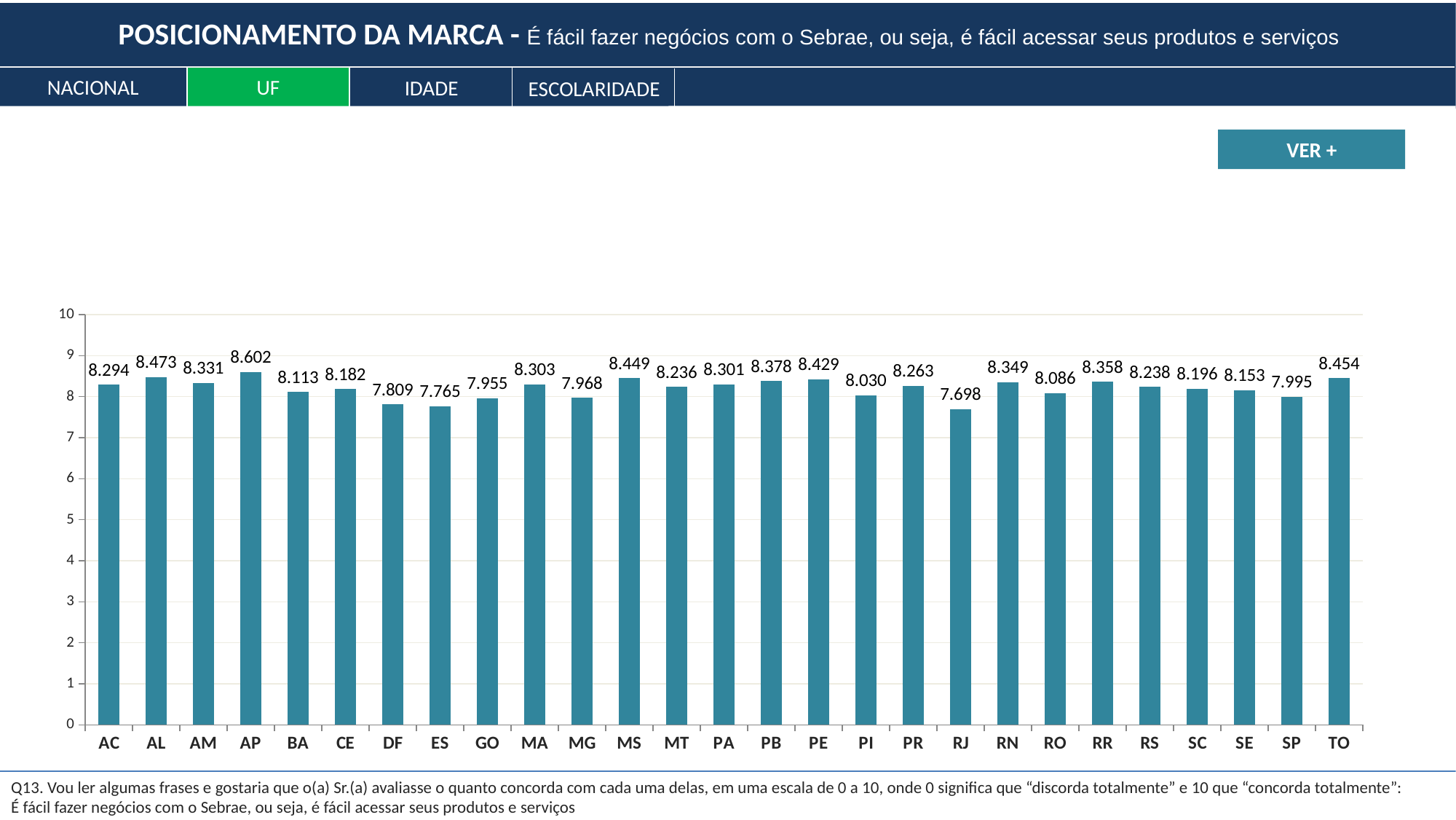
What is the difference between the values for AP and RJ? 0.904 What is the value for SP? 7.995 Which tab is highlighted in green at the top of the slide? UF Which UF has the lowest value? RJ How many UFs are shown on the x axis? 27 What is the value for RJ? 7.698 Is the value for DF greater or less than 8? less What is the value for AP? 8.602 What is the value for MS? 8.449 What kind of chart is shown on the slide? bar chart Which UF has the highest value? AP Which has a larger value, AL or AC? AL